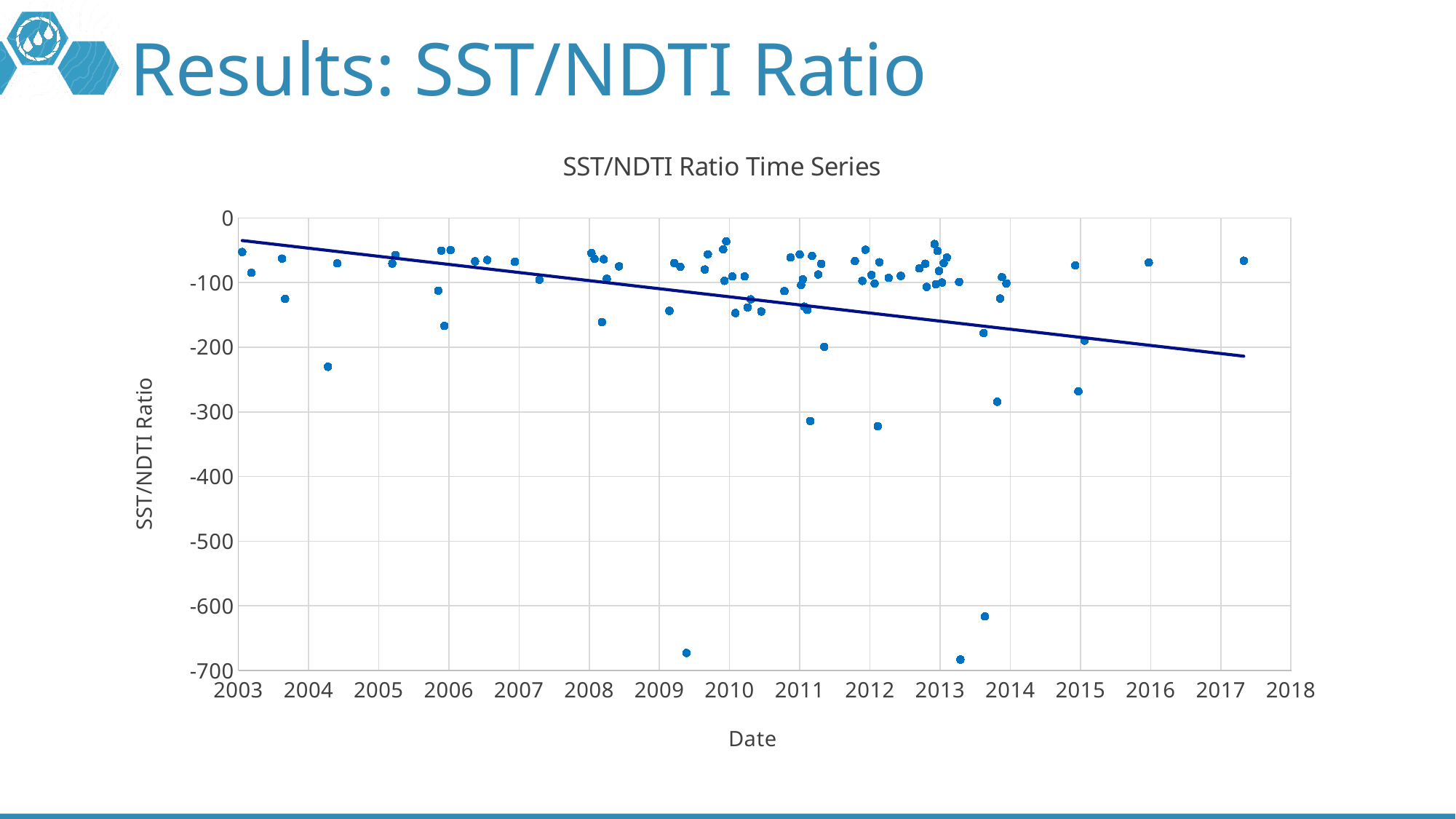
Is the point plotted near 2017 greater or less than -100? greater Does the trend line in the chart rise or fall from 2003 to 2017? Fall What is the title of the chart? SST/NDTI Ratio Time Series Is the value of the trend line at 2003 greater or less than -100? greater How many year labels are shown on the x axis? 16 What kind of chart is shown on the slide? Scatter plot What is the label on the y axis of the chart? SST/NDTI Ratio Is the lowest point plotted near 2009 greater or less than -600? less